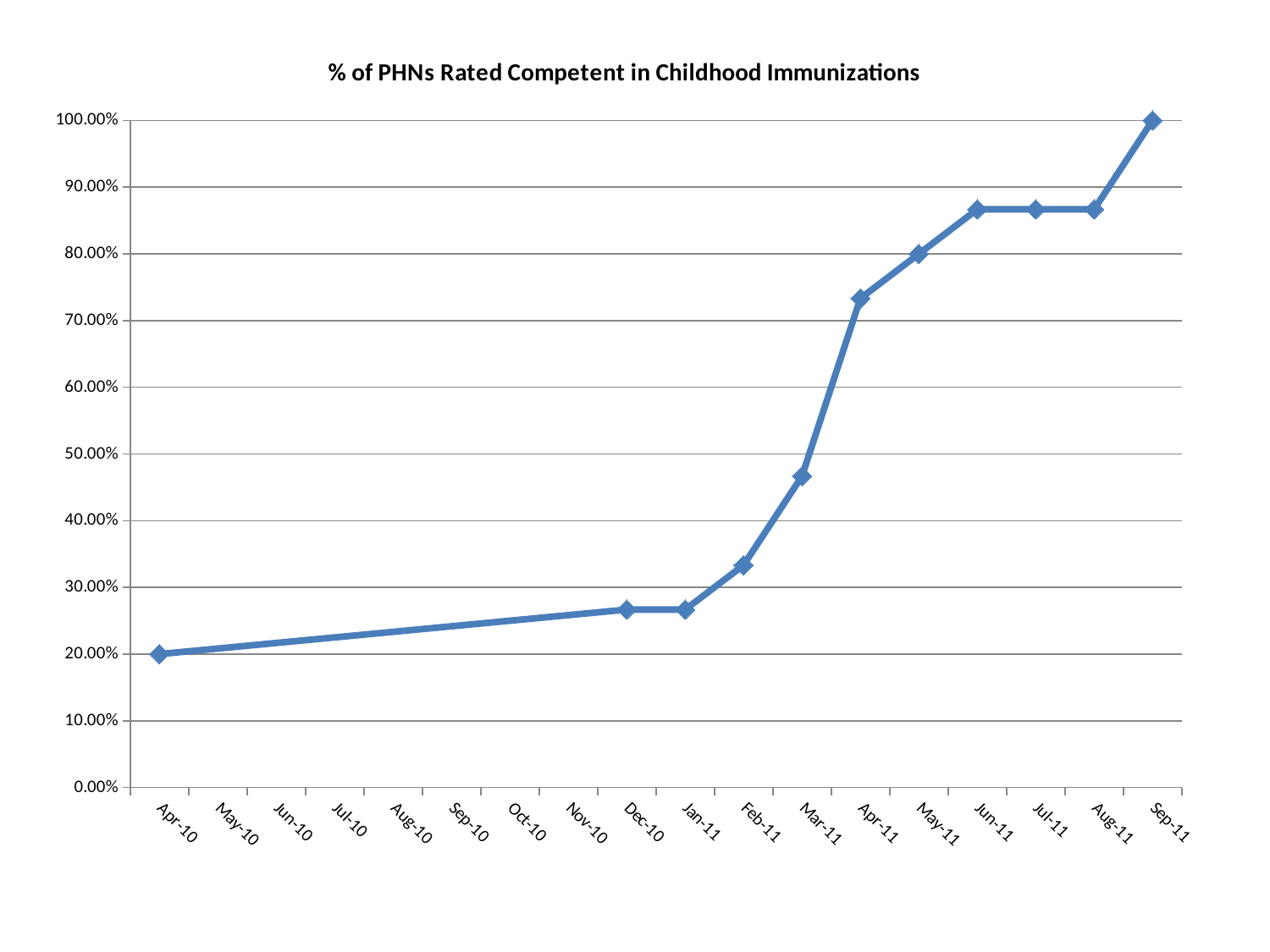
What is the title of the chart? % of PHNs Rated Competent in Childhood Immunizations What is the value for Sep-11? 100.00% Is the value for Apr-11 greater or less than 70.00%? greater What is the value for Apr-10? 20.00% What is the difference between the value for Sep-11 and the value for Apr-10? 80.00% Which month has the highest value? Sep-11 Is the value for Mar-11 greater or less than 50.00%? less Which is larger, the value for Feb-11 or the value for Apr-11? Apr-11 Which month has the lowest value? Apr-10 What type of chart is shown on the slide? Line chart What is the value for May-11? 80.00% Do the values generally rise or fall from Apr-10 to Sep-11? Rise